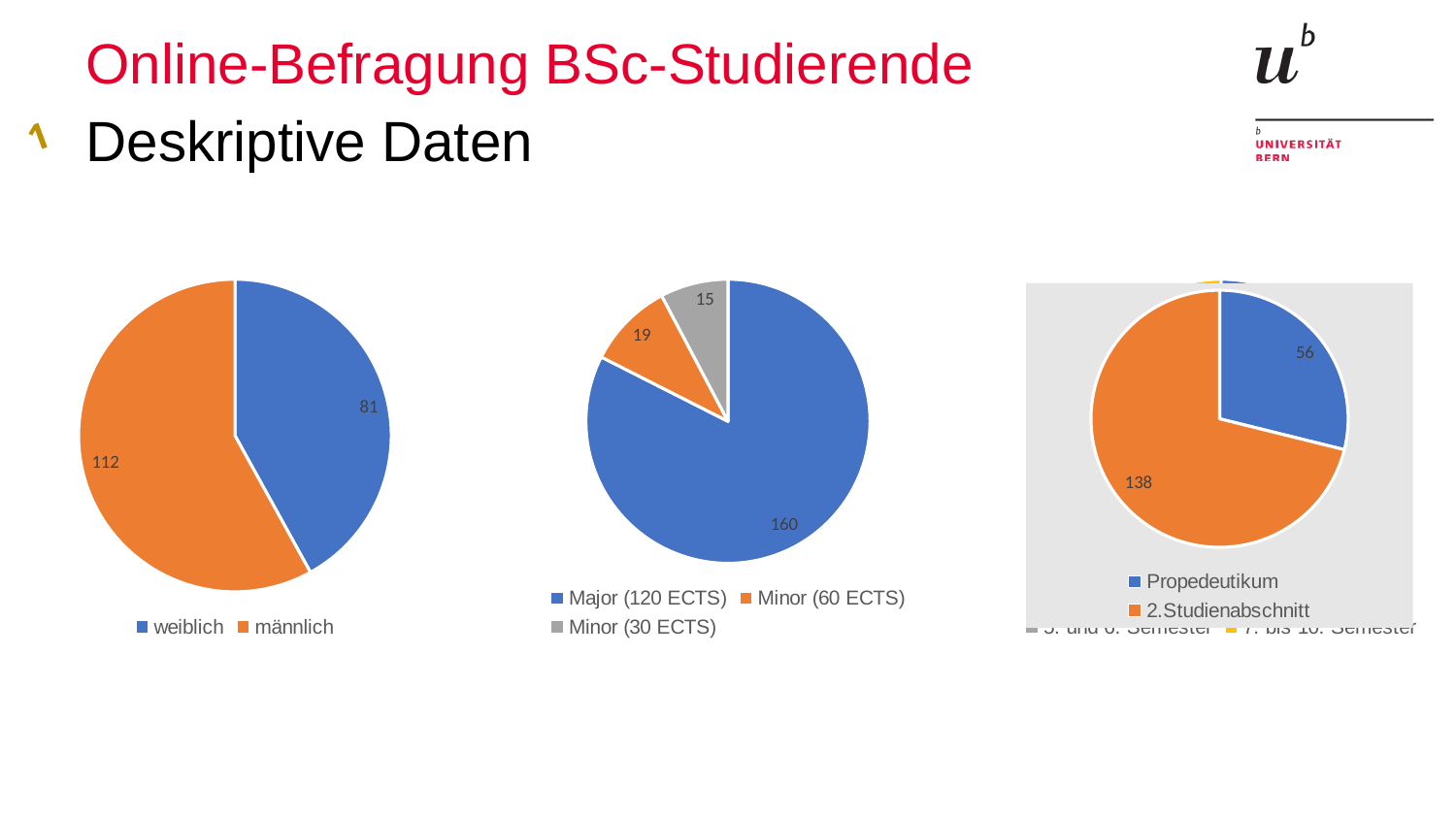
In the left pie chart, what is the difference between the männlich and weiblich values? 31 In the right pie chart, what is the value for 2.Studienabschnitt? 138 How many categories does the middle pie chart show? 3 In the middle pie chart, which category has the smallest value? Minor (30 ECTS) In the middle pie chart, what is the difference between Minor (60 ECTS) and Minor (30 ECTS)? 4 In the left pie chart, what is the value for weiblich? 81 What type of chart is the left chart? pie chart In the right pie chart, what is the value for Propedeutikum? 56 In the middle pie chart, what is the value for Minor (60 ECTS)? 19 In the left pie chart, what is the value for männlich? 112 In the middle pie chart, what is the value for Major (120 ECTS)? 160 In the left pie chart, which category has the larger value, weiblich or männlich? männlich